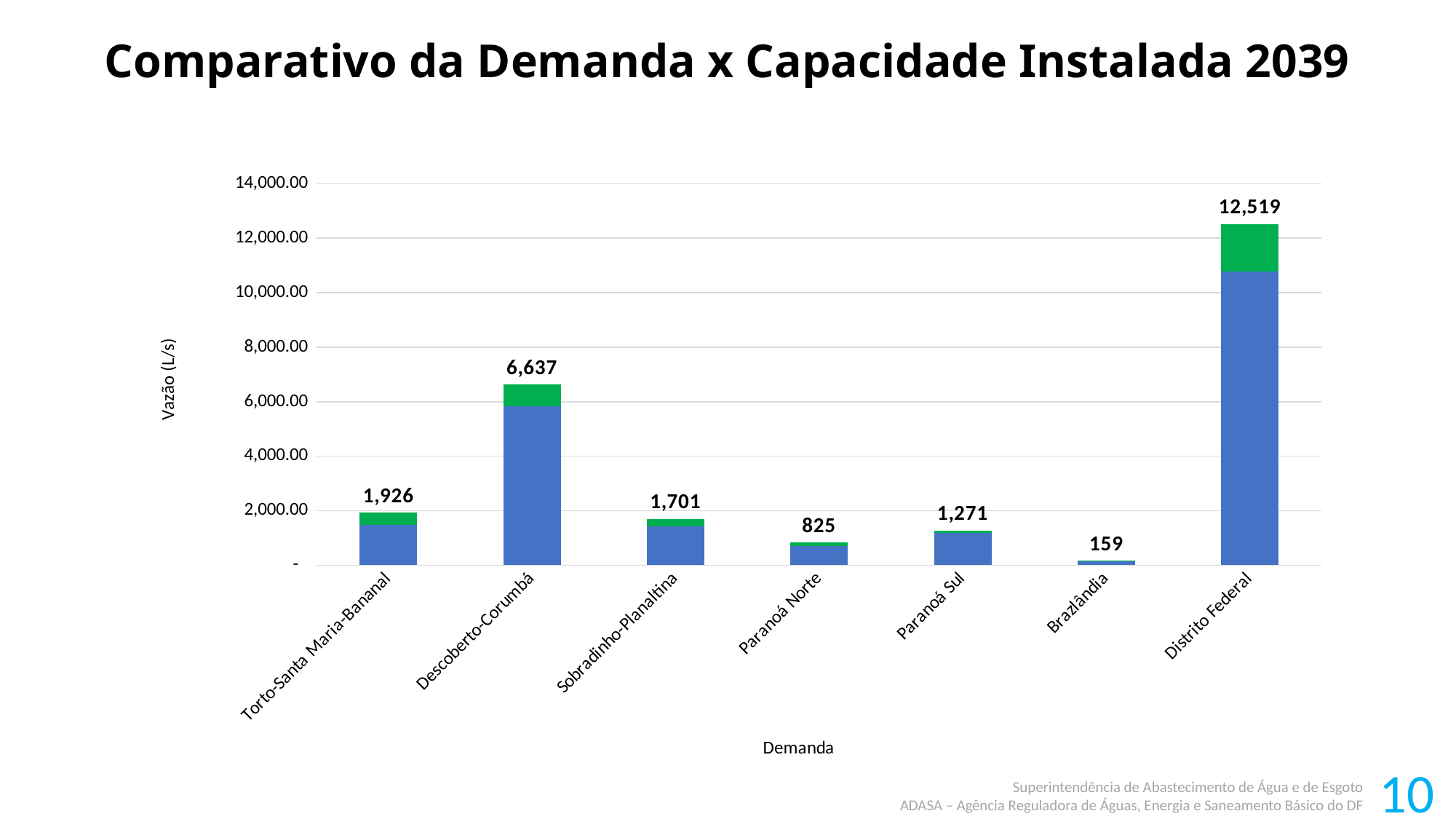
How many categories are shown on the x axis? 7 What is the total value labelled for Distrito Federal? 12,519 What is the difference between the totals for Torto-Santa Maria-Bananal and Sobradinho-Planaltina? 225 Which category has the lowest total value? Brazlândia Which category has the highest total value? Distrito Federal What is the total value labelled for Brazlândia? 159 What kind of chart is shown on the slide? Stacked bar chart What is the total value labelled for Paranoá Norte? 825 What is the total value labelled for Descoberto-Corumbá? 6,637 Which has a larger total, Paranoá Sul or Paranoá Norte? Paranoá Sul What is the difference between the totals for Distrito Federal and Descoberto-Corumbá? 5,882 Is the blue segment of the Distrito Federal bar greater or less than 10,000.00? greater